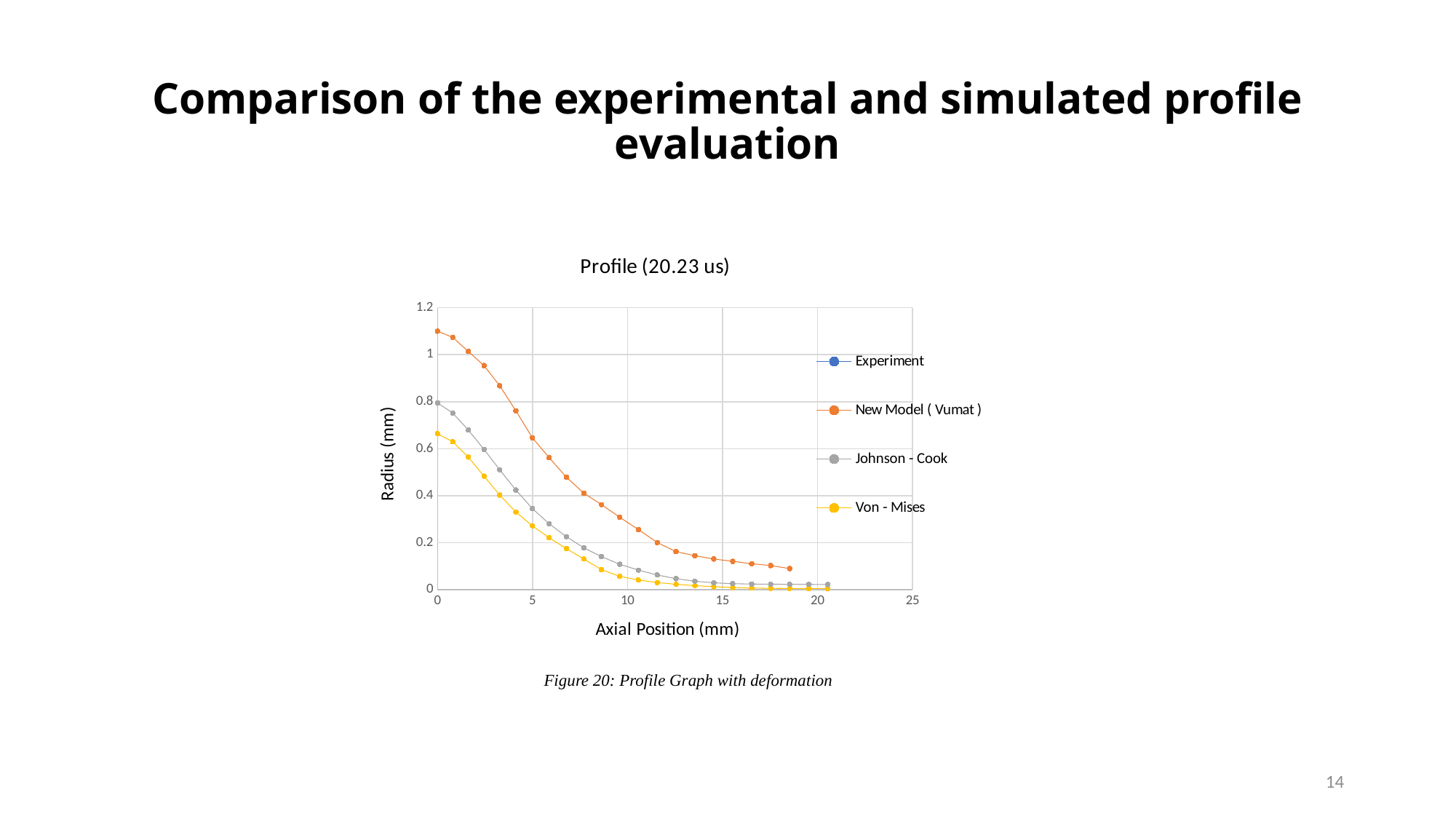
What is the title of the chart? Profile (20.23 us) Is the value of the New Model ( Vumat ) series at axial position 0 greater or less than 1? greater Is the value of the New Model ( Vumat ) series at axial position 10 greater or less than 0.2? greater Is the value of the Johnson - Cook series at axial position 5 greater or less than 0.4? less What kind of chart is shown on the slide? line chart At axial position 5, which series has the larger radius: New Model ( Vumat ) or Johnson - Cook? New Model ( Vumat ) Do the values of the New Model ( Vumat ) series rise or fall as axial position increases? fall At axial position 0, which series has the smaller radius: Johnson - Cook or Von - Mises? Von - Mises How many series does the legend of the chart list? 4 What is the label of the vertical axis of the chart? Radius (mm)